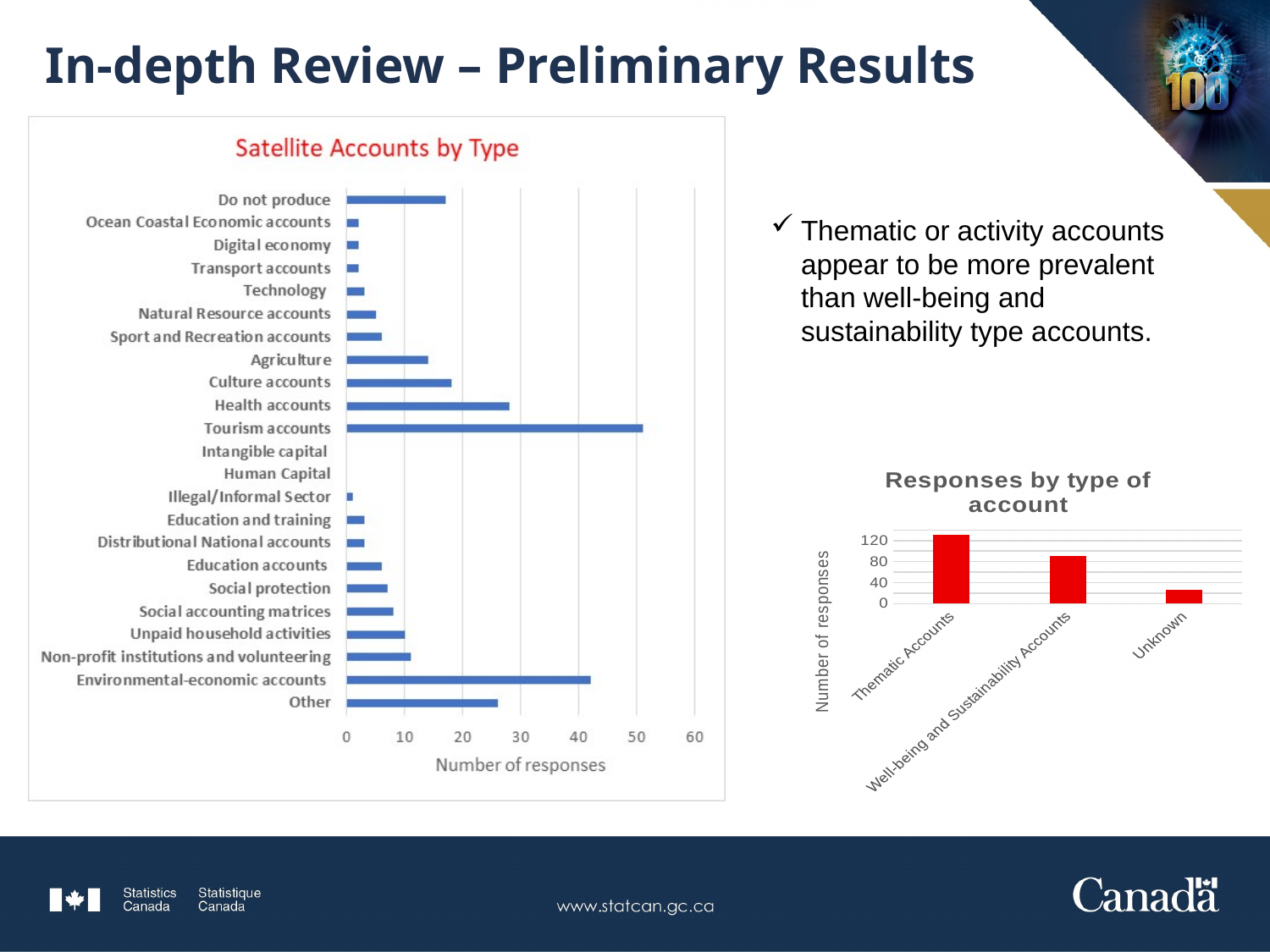
In the 'Satellite Accounts by Type' chart, is the value for Do not produce greater or less than 20? less In the 'Satellite Accounts by Type' chart, is the value for Tourism accounts greater or less than 40? greater What kind of chart is 'Satellite Accounts by Type'? Bar chart In the 'Satellite Accounts by Type' chart, which category has the highest number of responses? Tourism accounts In the 'Responses by type of account' chart, which category has the highest value? Thematic Accounts In the 'Satellite Accounts by Type' chart, is the value for Environmental-economic accounts greater or less than 30? greater In the 'Satellite Accounts by Type' chart, which is larger, Health accounts or Culture accounts? Health accounts In the 'Satellite Accounts by Type' chart, which is larger, Tourism accounts or Environmental-economic accounts? Tourism accounts What is the x-axis title of the 'Satellite Accounts by Type' chart? Number of responses How many categories are listed in the 'Satellite Accounts by Type' chart? 23 In the 'Responses by type of account' chart, which category has the lowest value? Unknown